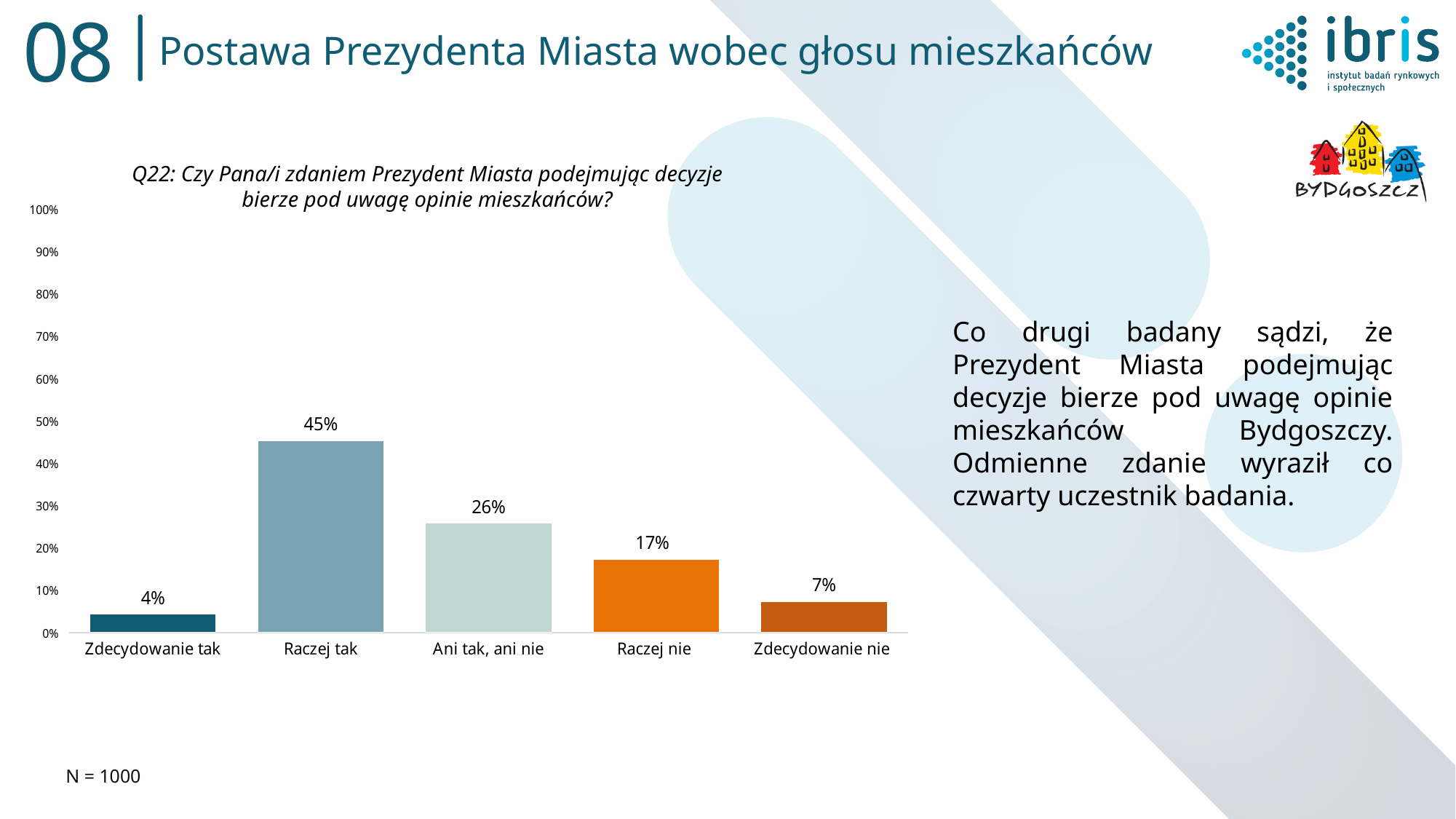
Is the value for "Raczej tak" greater or less than 40%? greater What is the value for "Ani tak, ani nie"? 26% Which is larger, the value for "Ani tak, ani nie" or the value for "Raczej nie"? Ani tak, ani nie What is the sample size (N) stated below the chart? N = 1000 What is the value for "Zdecydowanie nie"? 7% What is the value for "Raczej tak"? 45% How many categories are shown on the x axis? 5 What is the value for "Zdecydowanie tak"? 4% Which category has the highest value? Raczej tak What kind of chart is shown on the slide? bar chart Which category has the lowest value? Zdecydowanie tak What is the difference between the values for "Raczej tak" and "Raczej nie"? 28%